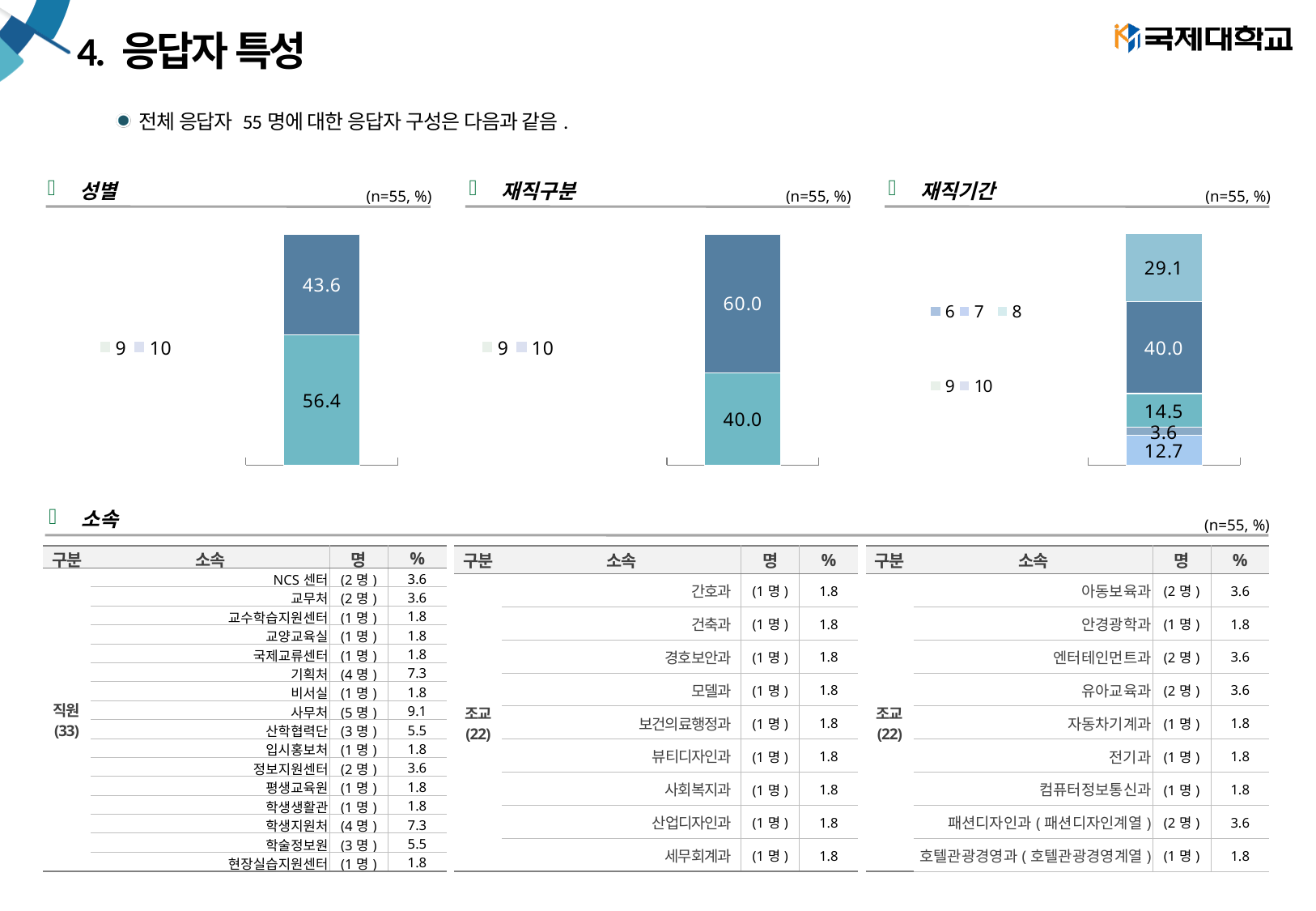
In the 재직기간 chart, what is the smallest value printed on any segment? 3.6 In the 재직구분 chart, what is the total of the two stacked segments? 100.0 In the 성별 chart, what value is printed on the top (dark blue) segment of the bar? 43.6 In the 재직구분 chart, what value is printed on the top segment of the bar? 60.0 In the 재직기간 chart, what is the largest value printed on any segment? 40.0 In the 성별 chart, what value is printed on the bottom (teal) segment of the bar? 56.4 In the 성별 chart, what is the difference between the bottom segment (56.4) and the top segment (43.6)? 12.8 In the 재직구분 chart, what value is printed on the bottom segment of the bar? 40.0 In the 재직구분 chart, which segment is larger, the top one or the bottom one? the top one (60.0) How many segments make up the stacked bar in the 재직기간 chart? 5 What kind of chart is the 성별 chart? stacked bar chart How many entries does the legend of the 재직기간 chart list? 5